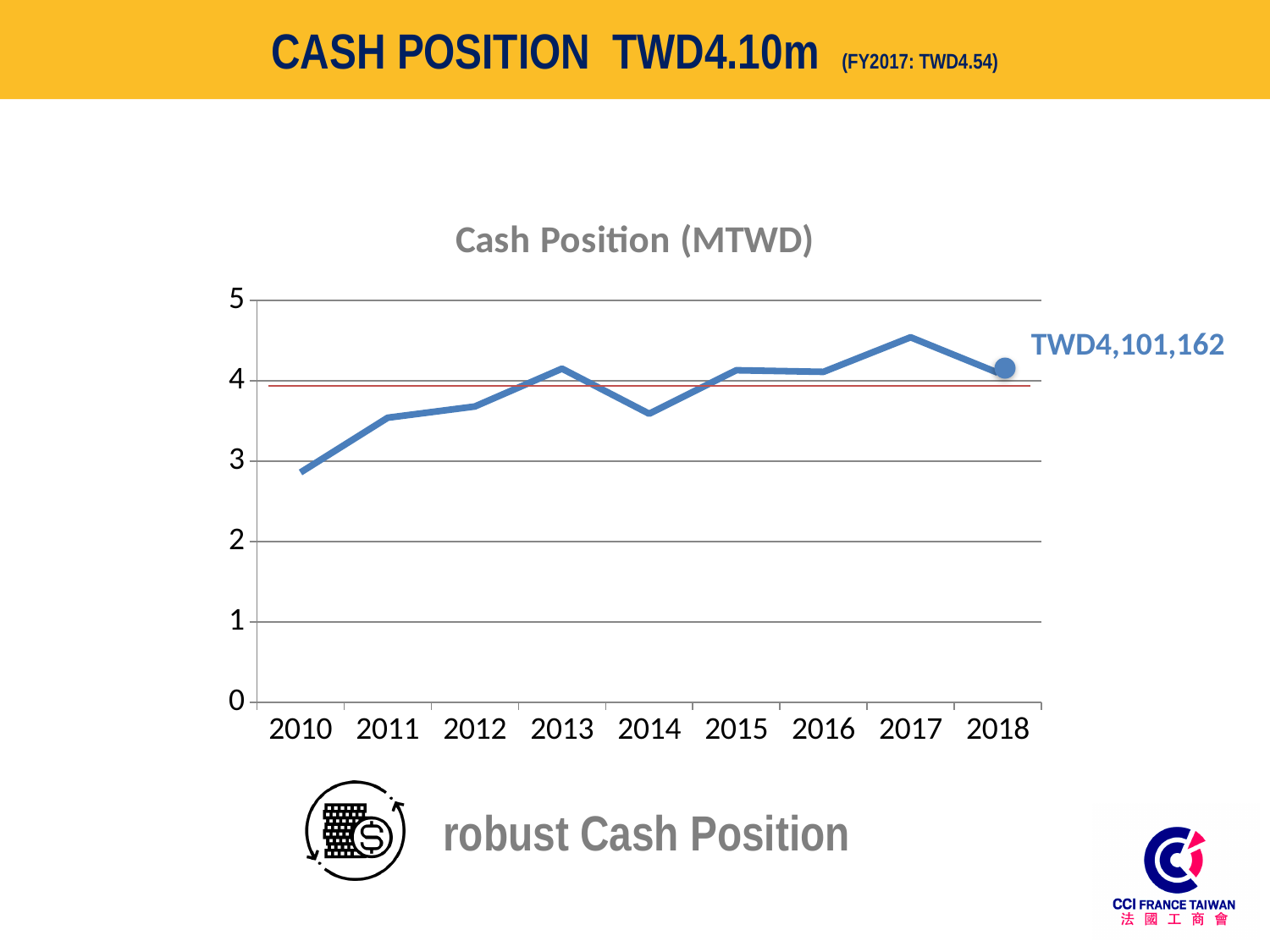
Which year has the lowest cash position on the chart? 2010 What value is labelled on the chart for 2018? TWD4,101,162 What kind of chart is shown on the slide? line chart How many years are plotted on the x axis of the chart? 9 Is the value for 2014 greater or less than 4? less Which is larger, the cash position in 2010 or in 2014? 2014 Is the value for 2010 greater or less than 3? less What is the title of the chart? Cash Position (MTWD) Does the cash position rise or fall from 2010 to 2013? rise Which year has the highest cash position on the chart? 2017 Which is larger, the cash position in 2011 or in 2013? 2013 Is the value for 2017 greater or less than 4? greater